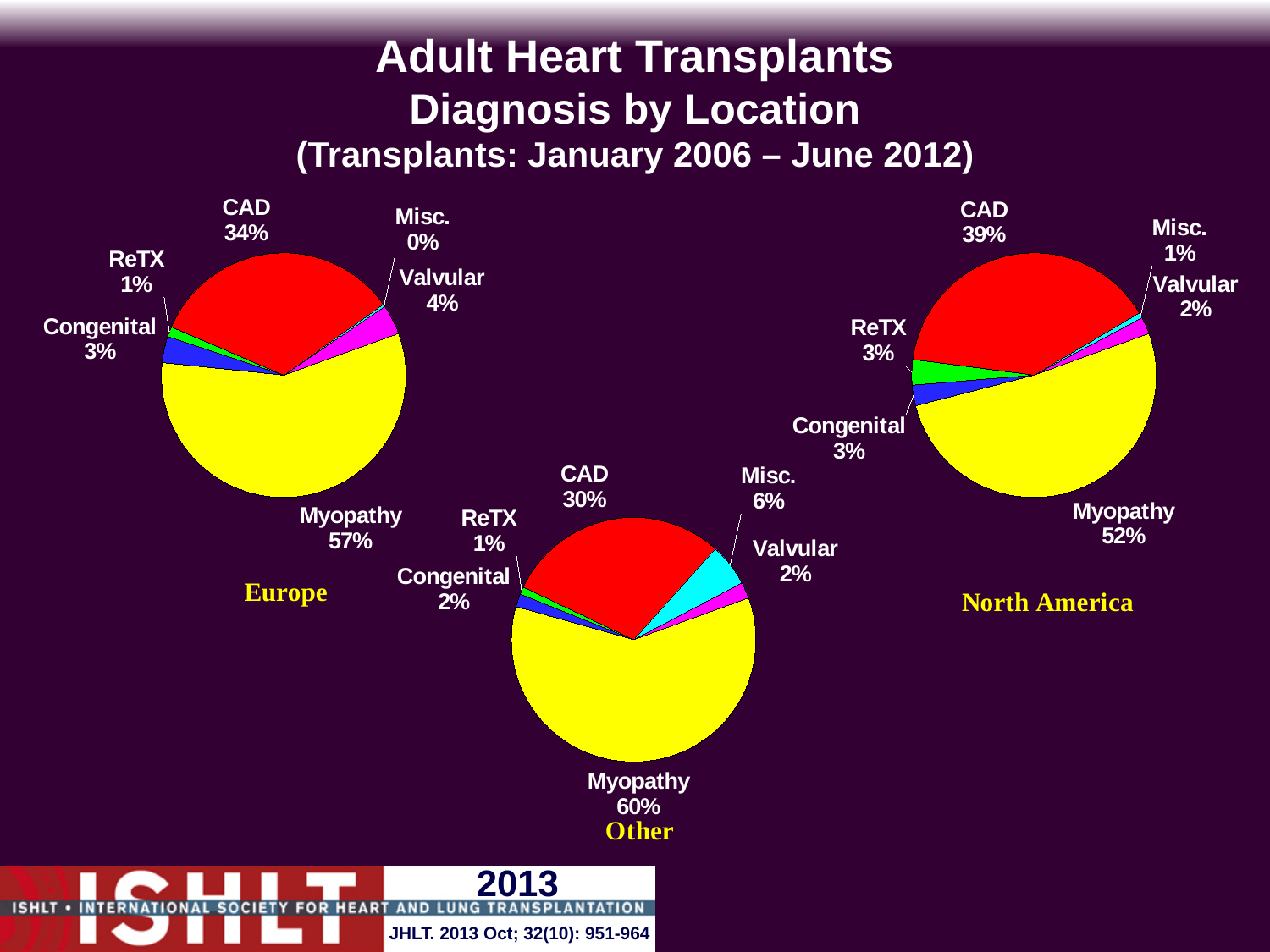
How many pie charts are on the slide? 3 In the Other pie chart, what is the difference between the Myopathy share and the CAD share? 30% In the North America pie chart, which diagnosis has the smallest share? Misc. In the Europe pie chart, which diagnosis has the smallest share? Misc. In the Europe pie chart, what share of transplants is Myopathy? 57% In the Other pie chart, what share of transplants is Misc.? 6% Which is larger: the CAD share in Europe or the CAD share in North America? North America How many diagnosis categories are shown in the Other pie chart? 6 What type of chart is used to show diagnosis by location on this slide? Pie chart In the North America pie chart, what is the difference between the Myopathy share and the CAD share? 13% In the Europe pie chart, which diagnosis has the largest share? Myopathy In the North America pie chart, what share of transplants is CAD? 39%